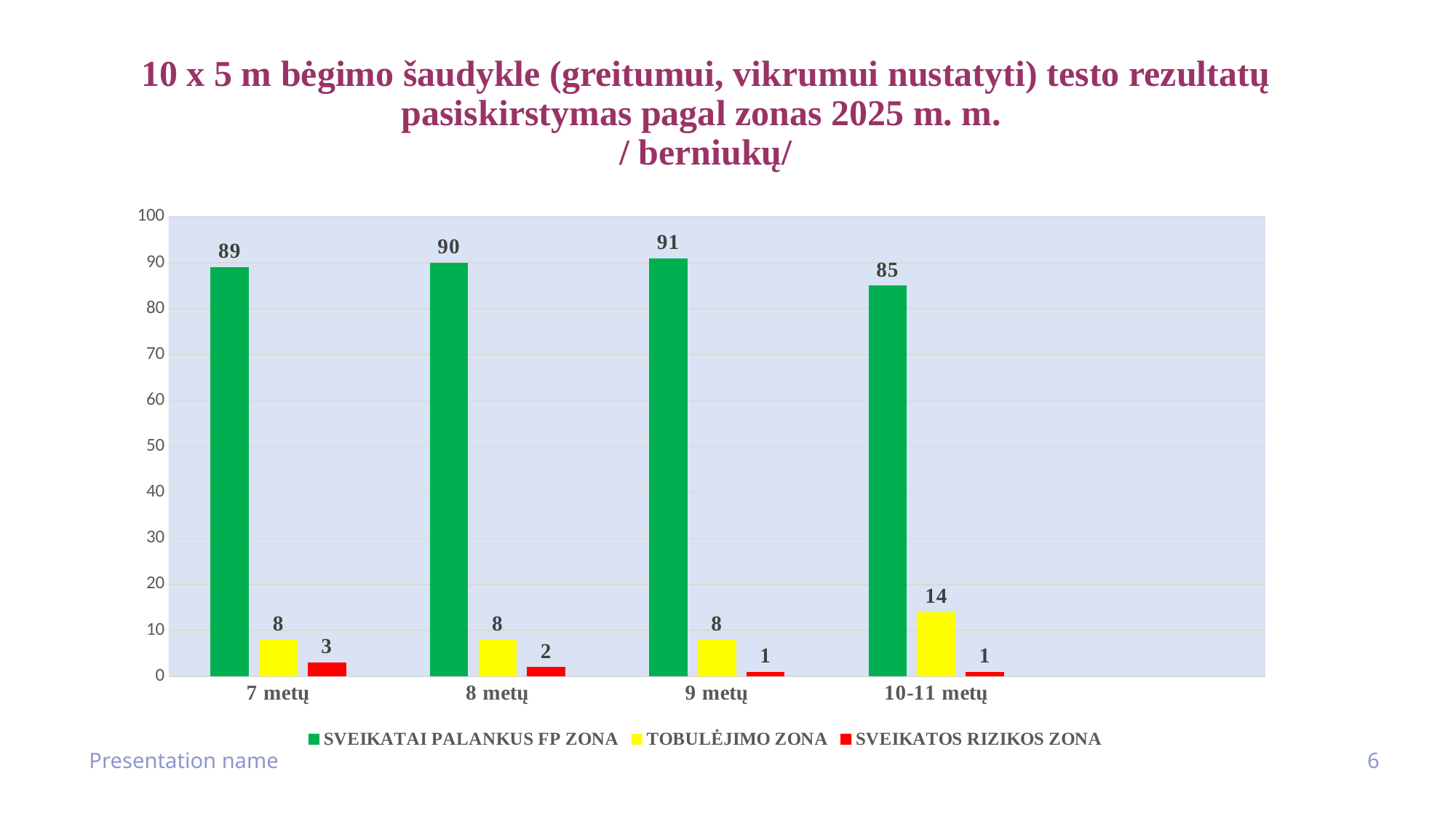
Which colour represents SVEIKATOS RIZIKOS ZONA in the chart? red Which age category has the lowest value for SVEIKATAI PALANKUS FP ZONA? 10-11 metų Which is larger: the TOBULĖJIMO ZONA value for 10-11 metų or for 9 metų? 10-11 metų How many series does the legend list? 3 What kind of chart is shown on the slide? bar chart Which age category has the highest value for SVEIKATAI PALANKUS FP ZONA? 9 metų How many age categories are shown on the x axis? 4 What is the value for SVEIKATOS RIZIKOS ZONA in the 8 metų category? 2 What is the value for SVEIKATAI PALANKUS FP ZONA in the 7 metų category? 89 What is the difference between the SVEIKATAI PALANKUS FP ZONA values for 9 metų and 10-11 metų? 6 Is the value for SVEIKATAI PALANKUS FP ZONA in the 10-11 metų category greater or less than 90? less What is the value for TOBULĖJIMO ZONA in the 10-11 metų category? 14